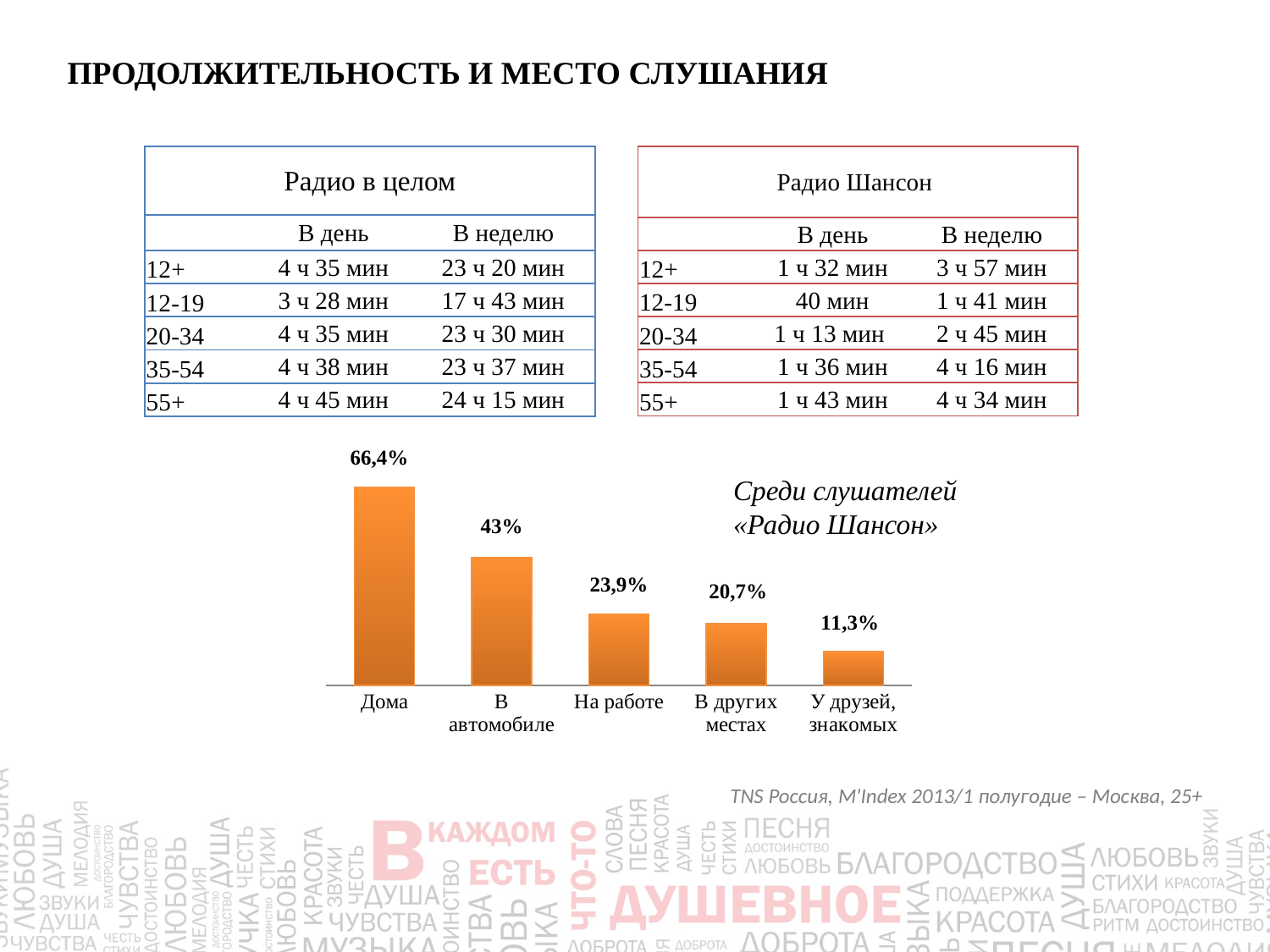
What is the value for У друзей, знакомых in the bar chart? 11,3% Do the values in the bar chart rise or fall from left to right? Fall Which category has the highest value in the bar chart? Дома What is the value for Дома in the bar chart? 66,4% What is the difference between the values for На работе and В других местах in the bar chart? 3,2% How many categories are shown in the bar chart? 5 What is the value for На работе in the bar chart? 23,9% Which is larger in the bar chart: the value for В автомобиле or the value for На работе? В автомобиле What is the value for В автомобиле in the bar chart? 43% What is the difference between the values for Дома and В автомобиле in the bar chart? 23,4% What kind of chart is shown on the slide? Bar chart Which category has the lowest value in the bar chart? У друзей, знакомых